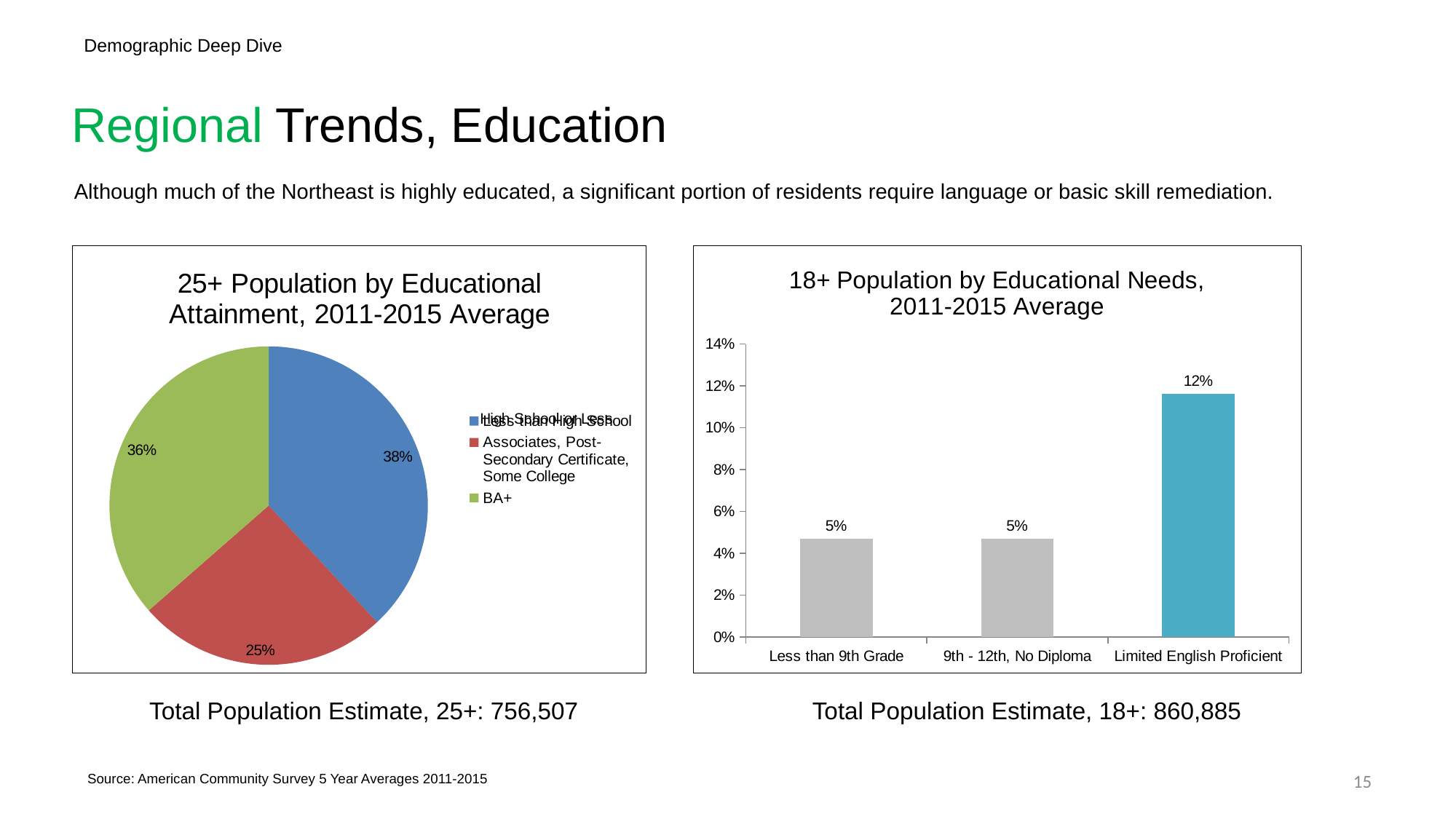
In the bar chart '18+ Population by Educational Needs, 2011-2015 Average', what is the value for Limited English Proficient? 12% In the bar chart '18+ Population by Educational Needs, 2011-2015 Average', how many categories are shown? 3 In the bar chart '18+ Population by Educational Needs, 2011-2015 Average', is the value for Limited English Proficient greater or less than 10%? greater In the pie chart '25+ Population by Educational Attainment, 2011-2015 Average', which is larger: BA+ or 'Associates, Post-Secondary Certificate, Some College'? BA+ In the pie chart '25+ Population by Educational Attainment, 2011-2015 Average', what share does 'Associates, Post-Secondary Certificate, Some College' have? 25% In the pie chart '25+ Population by Educational Attainment, 2011-2015 Average', what colour is the BA+ slice? green What kind of chart is '25+ Population by Educational Attainment, 2011-2015 Average'? pie chart What kind of chart is '18+ Population by Educational Needs, 2011-2015 Average'? bar chart In the bar chart '18+ Population by Educational Needs, 2011-2015 Average', what is the value for Less than 9th Grade? 5% In the bar chart '18+ Population by Educational Needs, 2011-2015 Average', which category has the highest value? Limited English Proficient In the pie chart '25+ Population by Educational Attainment, 2011-2015 Average', what share does BA+ have? 36% In the bar chart '18+ Population by Educational Needs, 2011-2015 Average', what is the difference between Limited English Proficient and 9th - 12th, No Diploma? 7%